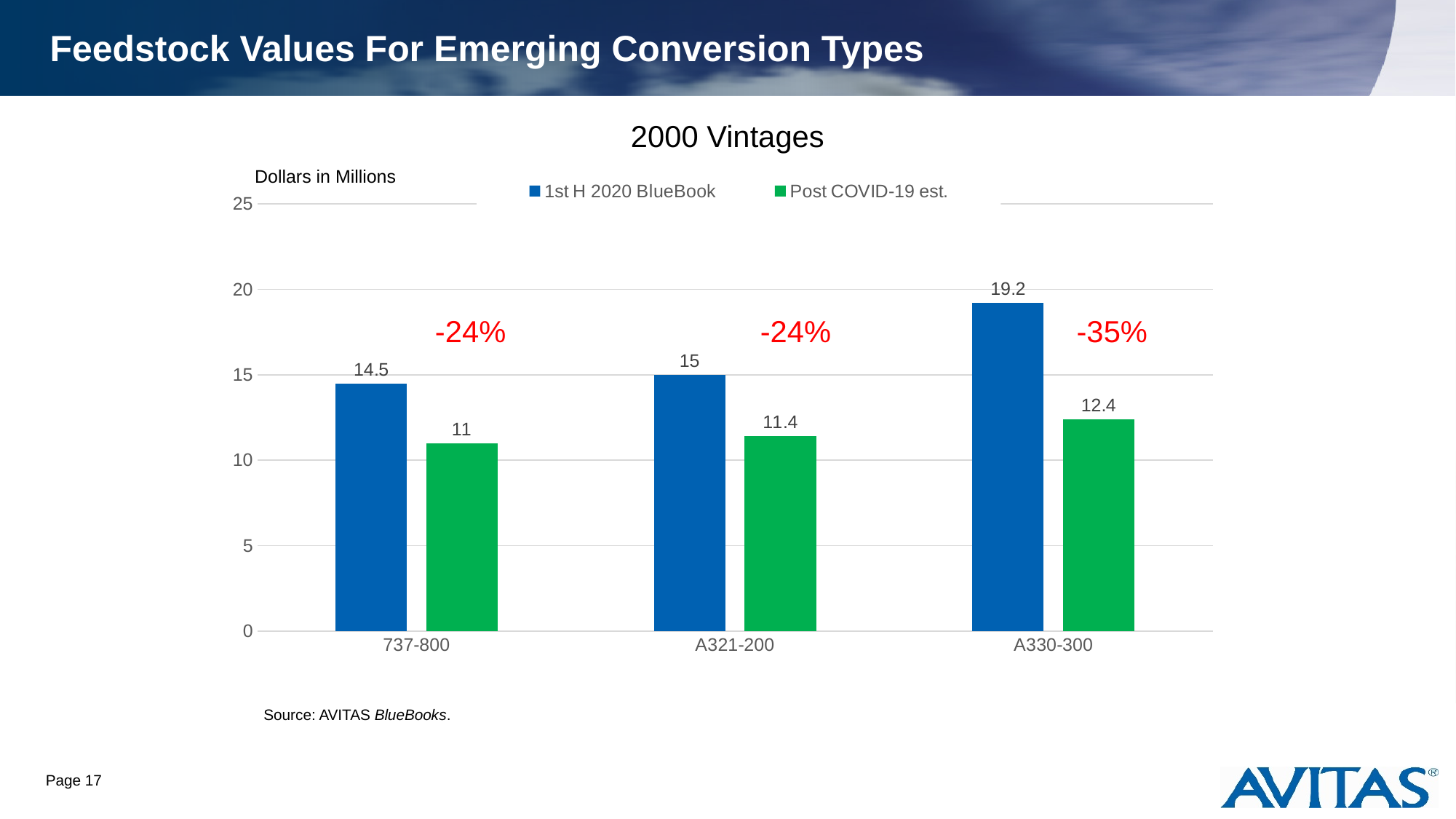
What is the 1st H 2020 BlueBook value for the 737-800? 14.5 What kind of chart is shown on the slide? bar chart How many series does the legend list? 2 How many aircraft types are shown on the x axis? 3 What is the Post COVID-19 est. value for the A321-200? 11.4 What is the difference between the 1st H 2020 BlueBook value and the Post COVID-19 est. value for the A330-300? 6.8 Which aircraft type has the highest 1st H 2020 BlueBook value? A330-300 Which is larger for the A321-200: the 1st H 2020 BlueBook value or the Post COVID-19 est. value? 1st H 2020 BlueBook Which aircraft type has the lowest Post COVID-19 est. value? 737-800 What is the Post COVID-19 est. value for the A330-300? 12.4 What percentage change is annotated above the A330-300 bars? -35% Is the Post COVID-19 est. value for the 737-800 greater or less than 15? less